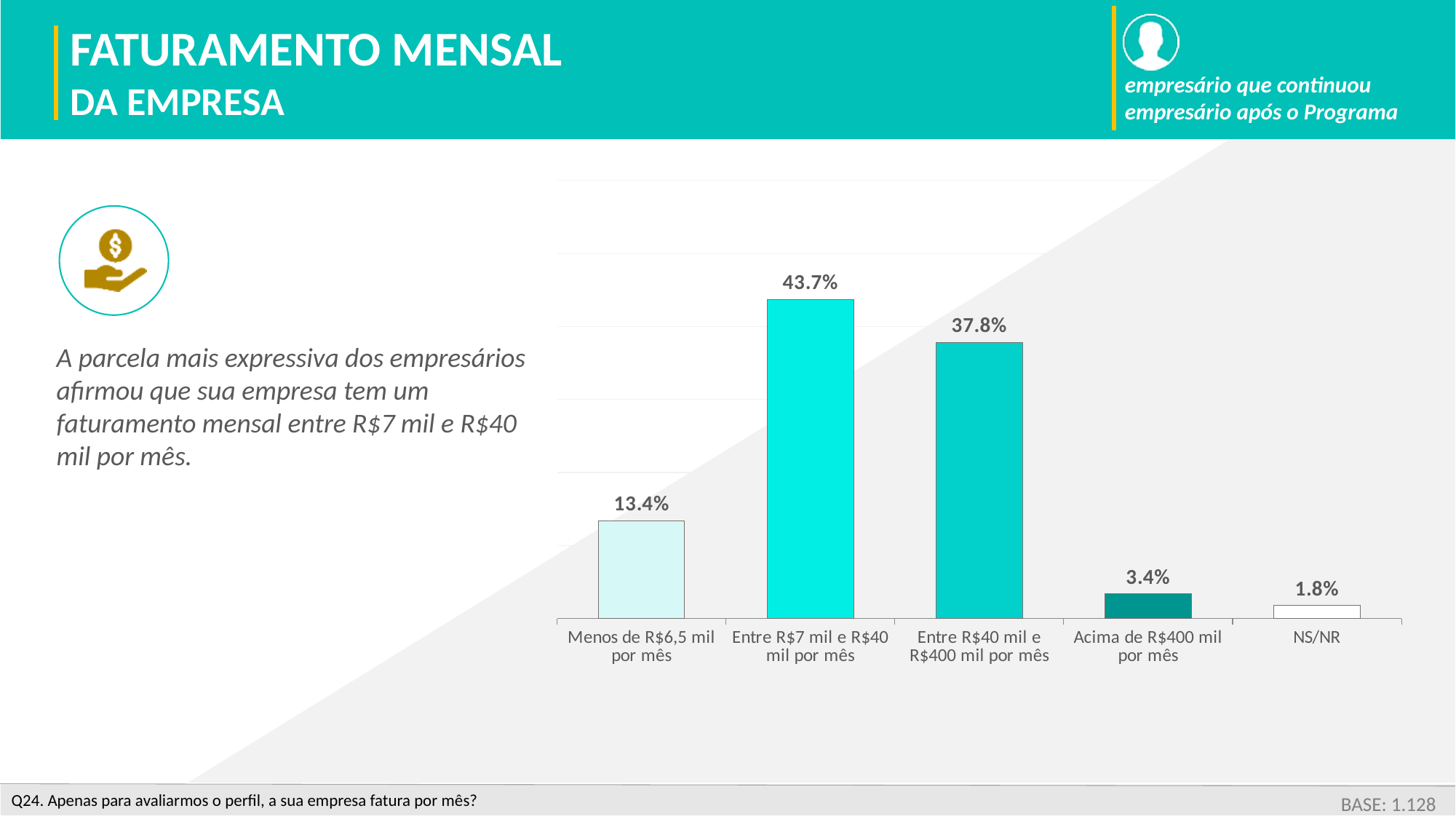
What is the value for "Menos de R$6,5 mil por mês"? 13.4% What is the difference between the values for "Entre R$7 mil e R$40 mil por mês" and "Entre R$40 mil e R$400 mil por mês"? 5.9% What is the value for "Entre R$7 mil e R$40 mil por mês"? 43.7% How many categories are shown in the chart? 5 Which category has the lowest value? NS/NR Which category has the highest value? Entre R$7 mil e R$40 mil por mês What is the value for "NS/NR"? 1.8% Which is larger: the value for "Entre R$40 mil e R$400 mil por mês" or the value for "Menos de R$6,5 mil por mês"? Entre R$40 mil e R$400 mil por mês What kind of chart is shown on the slide? Bar chart What is the value for "Acima de R$400 mil por mês"? 3.4% What is the base (number of respondents) shown on the slide? 1.128 What is the difference between the values for "Menos de R$6,5 mil por mês" and "Acima de R$400 mil por mês"? 10.0%